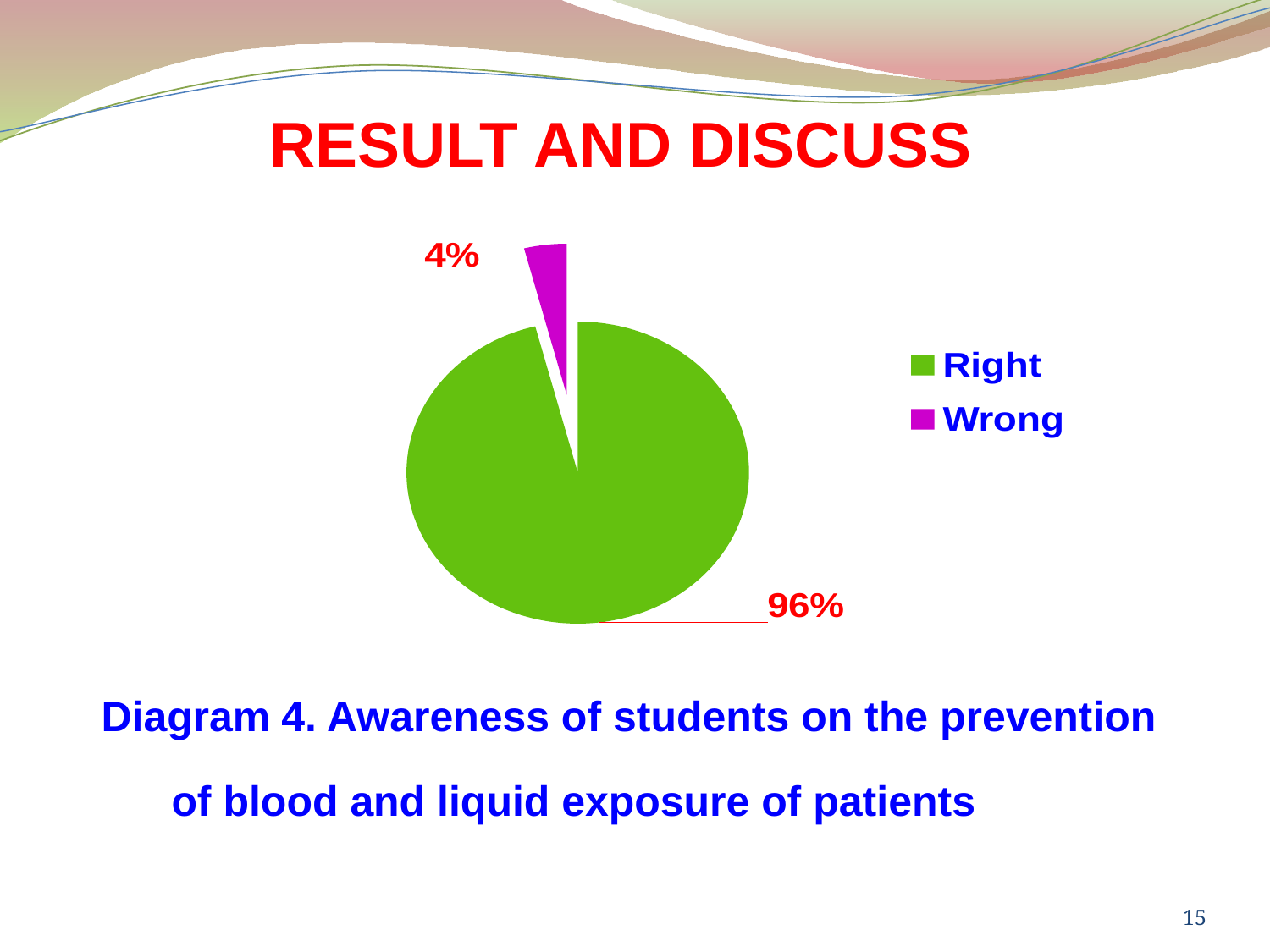
What colour is the Right slice of the pie? green What percentage of the pie is labelled Wrong? 4% What percentage of the pie is labelled Right? 96% What is the caption of the diagram below the pie chart? Diagram 4. Awareness of students on the prevention of blood and liquid exposure of patients What kind of chart is shown on the slide? pie chart How many entries does the legend list? 2 Which is larger, the Right slice or the Wrong slice? Right What share of the pie does the Wrong slice take? 4% Which slice of the pie is the smallest? Wrong Which slice of the pie is the largest? Right What is the difference in percentage points between the Right and Wrong slices? 92 How many slices does the pie chart have? 2